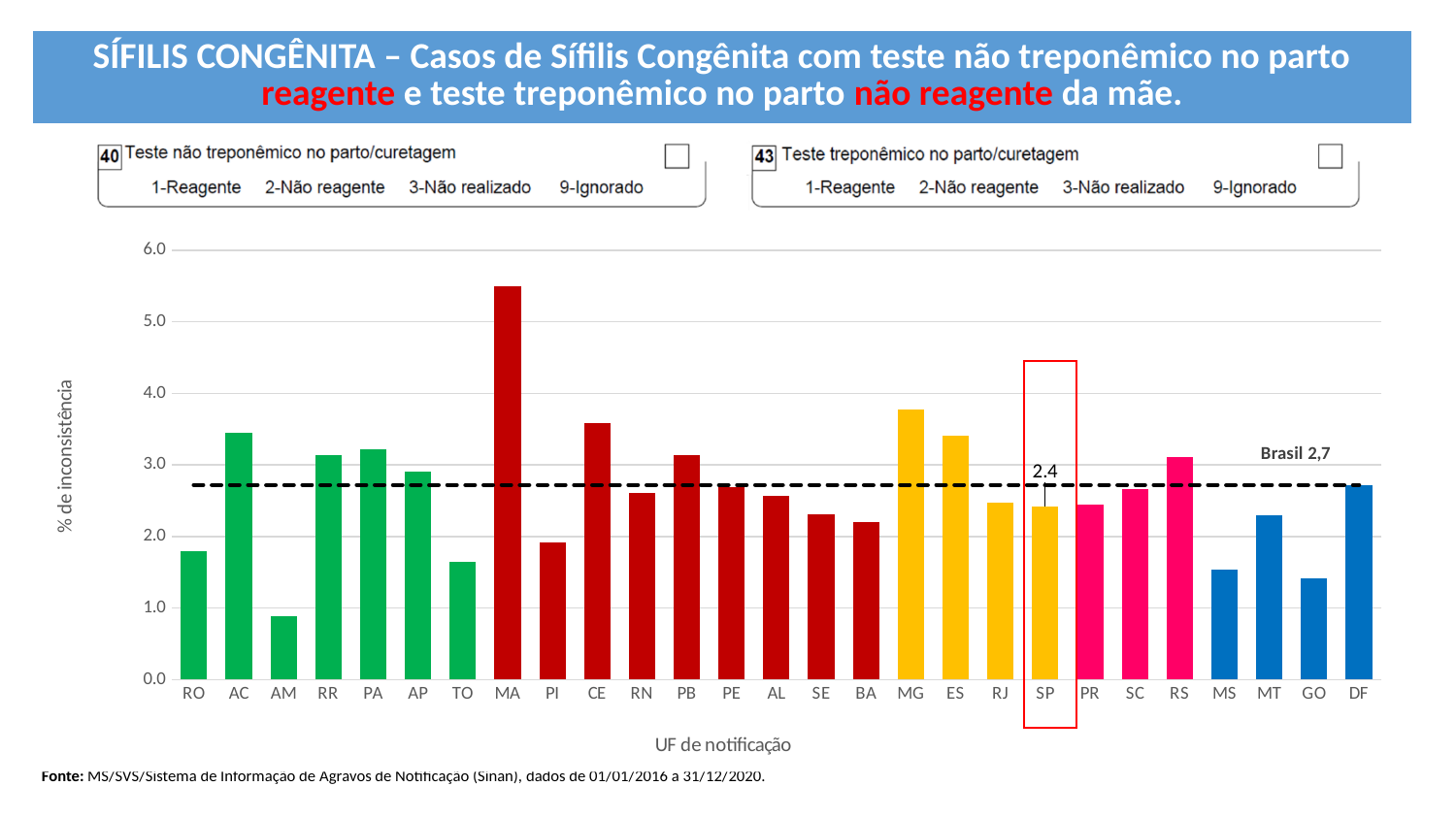
What is the label of the y axis? % de inconsistência Is the value for GO greater or less than 2.0? less What kind of chart is shown on the slide? bar chart What is the value shown for SP? 2.4 Which UF has the lowest value? AM Which UF has the highest value? MA Is the value for AM greater or less than 1.0? less Which has the larger value, MA or CE? MA Is the value for MG greater or less than 3.0? greater What value is shown for Brasil by the dashed reference line? 2,7 How many UFs are shown on the x axis? 27